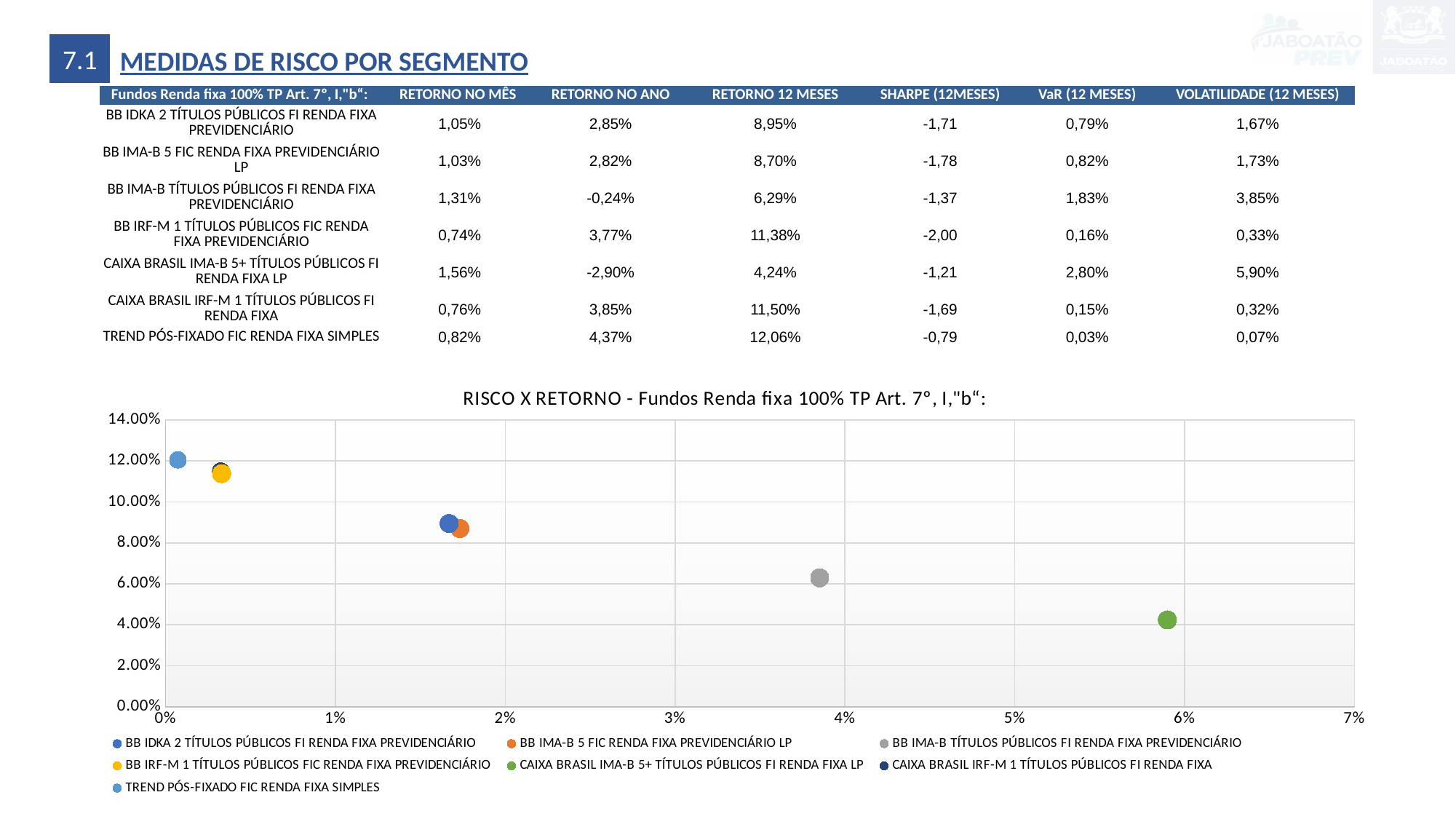
In the RISCO X RETORNO chart, what colour is the marker for CAIXA BRASIL IMA-B 5+ TÍTULOS PÚBLICOS FI RENDA FIXA LP? green In the RISCO X RETORNO chart, is the x-axis value for BB IMA-B TÍTULOS PÚBLICOS FI RENDA FIXA PREVIDENCIÁRIO greater or less than 3%? greater In the RISCO X RETORNO chart, which fund is plotted furthest to the right (highest risk)? CAIXA BRASIL IMA-B 5+ TÍTULOS PÚBLICOS FI RENDA FIXA LP In the RISCO X RETORNO chart, which fund has the lowest return (lowest point on the y axis)? CAIXA BRASIL IMA-B 5+ TÍTULOS PÚBLICOS FI RENDA FIXA LP In the RISCO X RETORNO chart, which has the higher return: BB IDKA 2 TÍTULOS PÚBLICOS FI RENDA FIXA PREVIDENCIÁRIO or BB IMA-B TÍTULOS PÚBLICOS FI RENDA FIXA PREVIDENCIÁRIO? BB IDKA 2 TÍTULOS PÚBLICOS FI RENDA FIXA PREVIDENCIÁRIO How many series does the legend of the RISCO X RETORNO chart list? 7 In the RISCO X RETORNO chart, is the return value for CAIXA BRASIL IMA-B 5+ TÍTULOS PÚBLICOS FI RENDA FIXA LP greater or less than 6.00%? less In the RISCO X RETORNO chart, is the return for TREND PÓS-FIXADO FIC RENDA FIXA SIMPLES greater or less than 10.00%? greater In the RISCO X RETORNO chart, do the returns rise or fall as risk increases along the x axis? fall In the RISCO X RETORNO chart, which fund has the highest return (highest point on the y axis)? TREND PÓS-FIXADO FIC RENDA FIXA SIMPLES What kind of chart is shown under the title 'RISCO X RETORNO'? scatter chart How many data points are plotted in the RISCO X RETORNO chart? 7